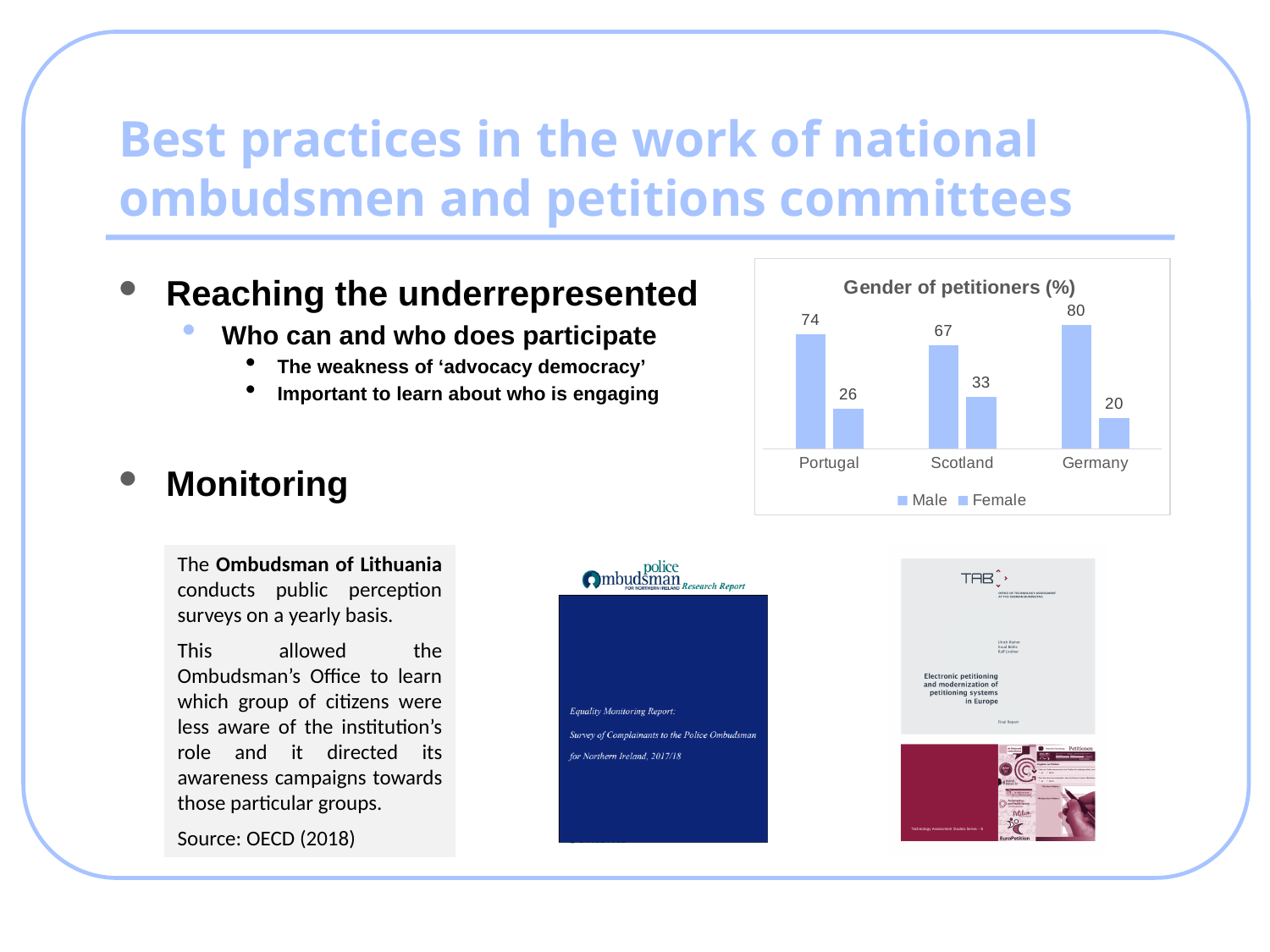
Which is larger in the 'Gender of petitioners (%)' chart: the Male value for Scotland or the Male value for Portugal? Male value for Portugal What are the two legend entries in the 'Gender of petitioners (%)' chart? Male and Female What is the Female value for Scotland in the 'Gender of petitioners (%)' chart? 33 What kind of chart is the 'Gender of petitioners (%)' chart? Bar chart What is the Male value for Portugal in the 'Gender of petitioners (%)' chart? 74 What is the Female value for Germany in the 'Gender of petitioners (%)' chart? 20 How many countries are shown in the 'Gender of petitioners (%)' chart? 3 Which country has the lowest Female value in the 'Gender of petitioners (%)' chart? Germany How many series does the legend of the 'Gender of petitioners (%)' chart list? 2 Which country has the highest Male value in the 'Gender of petitioners (%)' chart? Germany What is the difference between the Male and Female values for Portugal in the 'Gender of petitioners (%)' chart? 48 What is the title of the chart on the slide? Gender of petitioners (%)